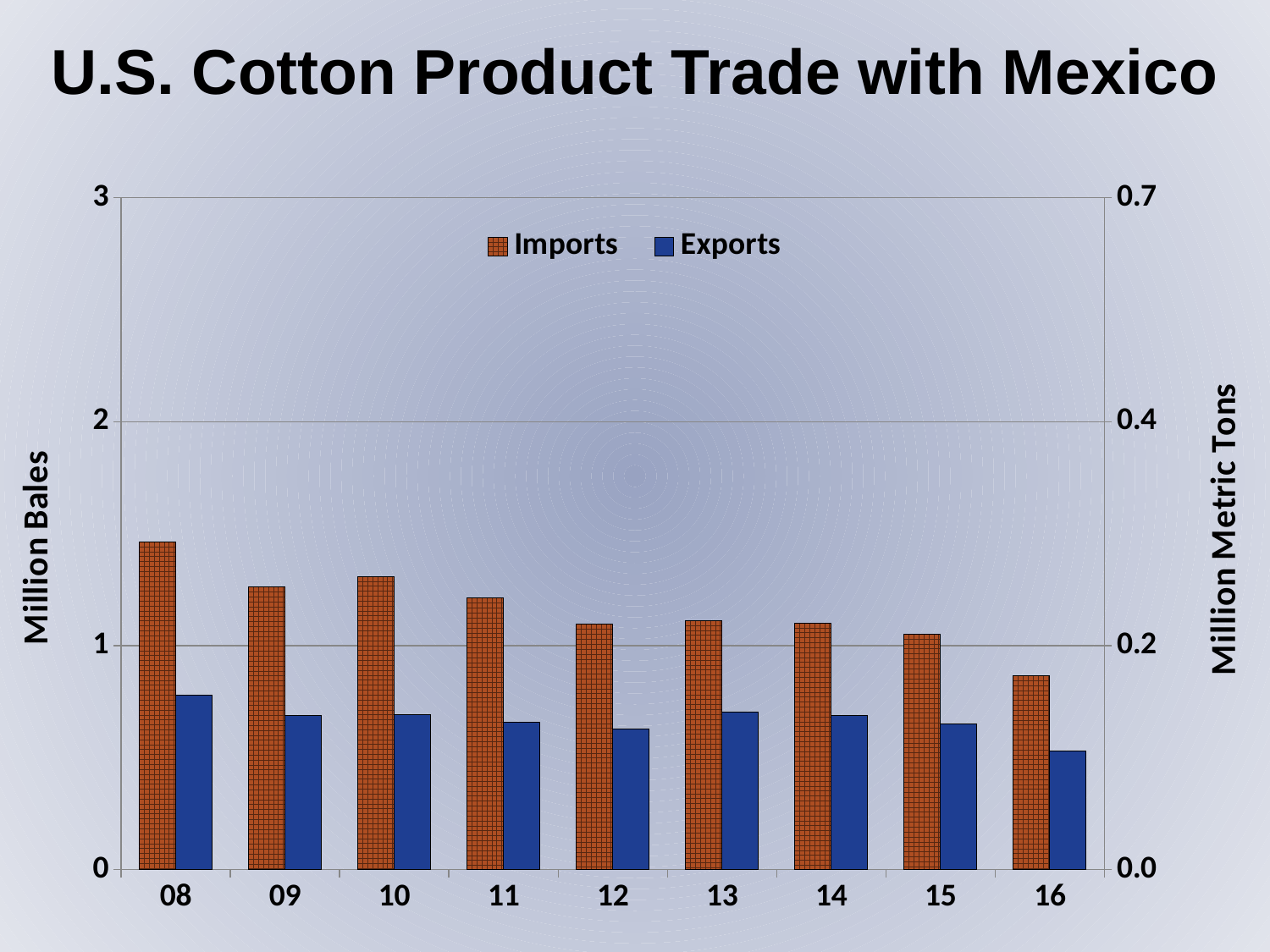
What is the title of the chart? U.S. Cotton Product Trade with Mexico What kind of chart is shown on the slide? bar chart Is the Imports value for 08 greater or less than 1 million bales? greater In which year are Imports highest? 08 In which year are Exports highest? 08 How many series does the legend list? 2 Which is larger in 12, Imports or Exports? Imports How many years are shown on the x axis? 9 In which year are Exports lowest? 16 Is the Imports value for 16 greater or less than 1 million bales? less Do Imports generally rise or fall from 08 to 16? fall In which year are Imports lowest? 16